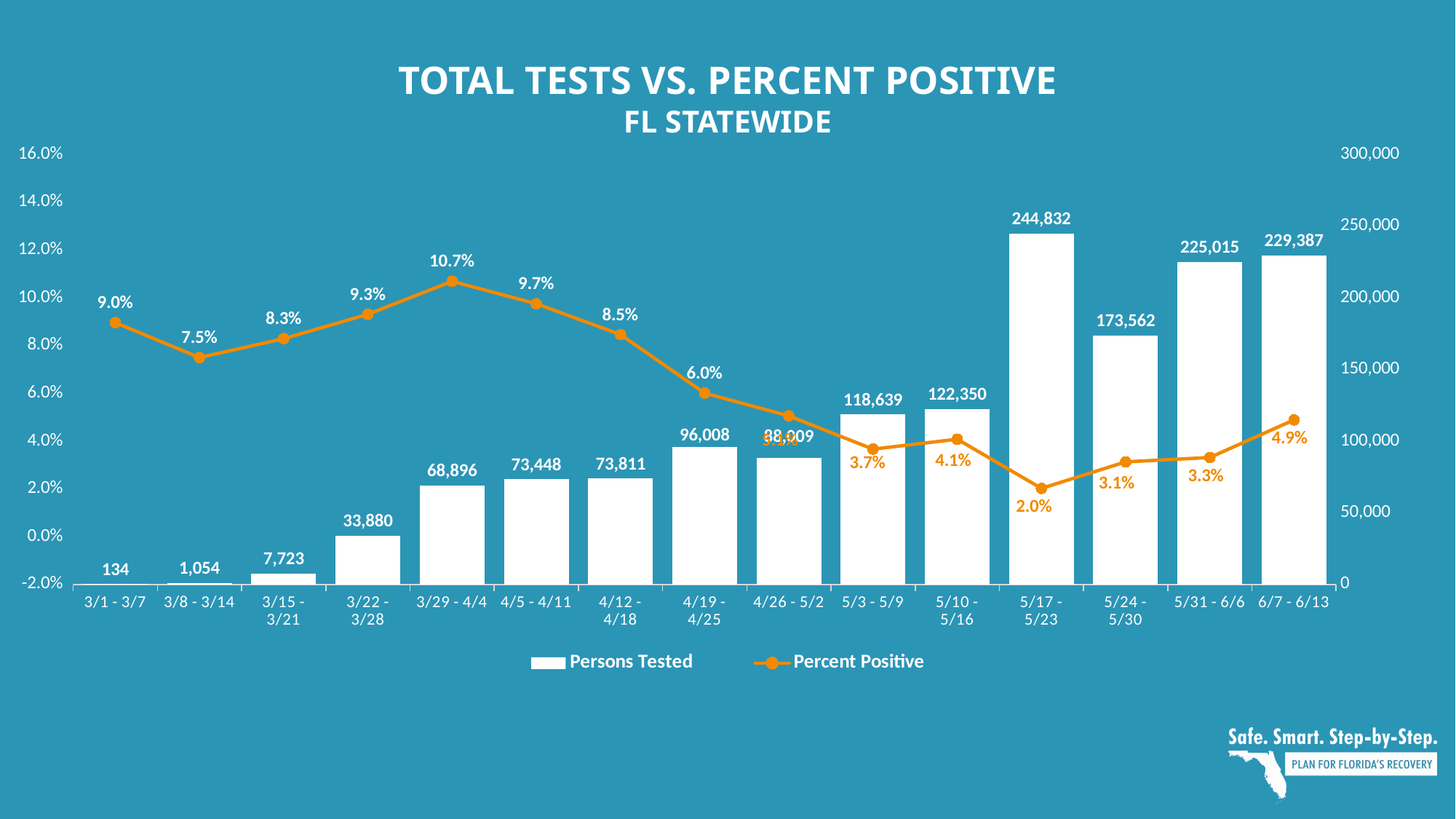
What was the percent positive for the week 3/29 - 4/4? 10.7% How many persons were tested in the week 3/1 - 3/7? 134 Which week has the lowest percent positive? 5/17 - 5/23 Which week has the highest number of persons tested? 5/17 - 5/23 Which week had more persons tested, 4/5 - 4/11 or 4/12 - 4/18? 4/12 - 4/18 How many series does the legend list? 2 What is the difference in persons tested between the weeks 6/7 - 6/13 and 5/31 - 6/6? 4,372 How many weekly periods are shown on the x axis? 15 Does the percent positive rise or fall from the week 4/19 - 4/25 to the week 5/17 - 5/23? Fall What kind of chart is this? Combined bar and line chart Which week has the highest percent positive? 3/29 - 4/4 How many persons were tested in the week 5/17 - 5/23? 244,832